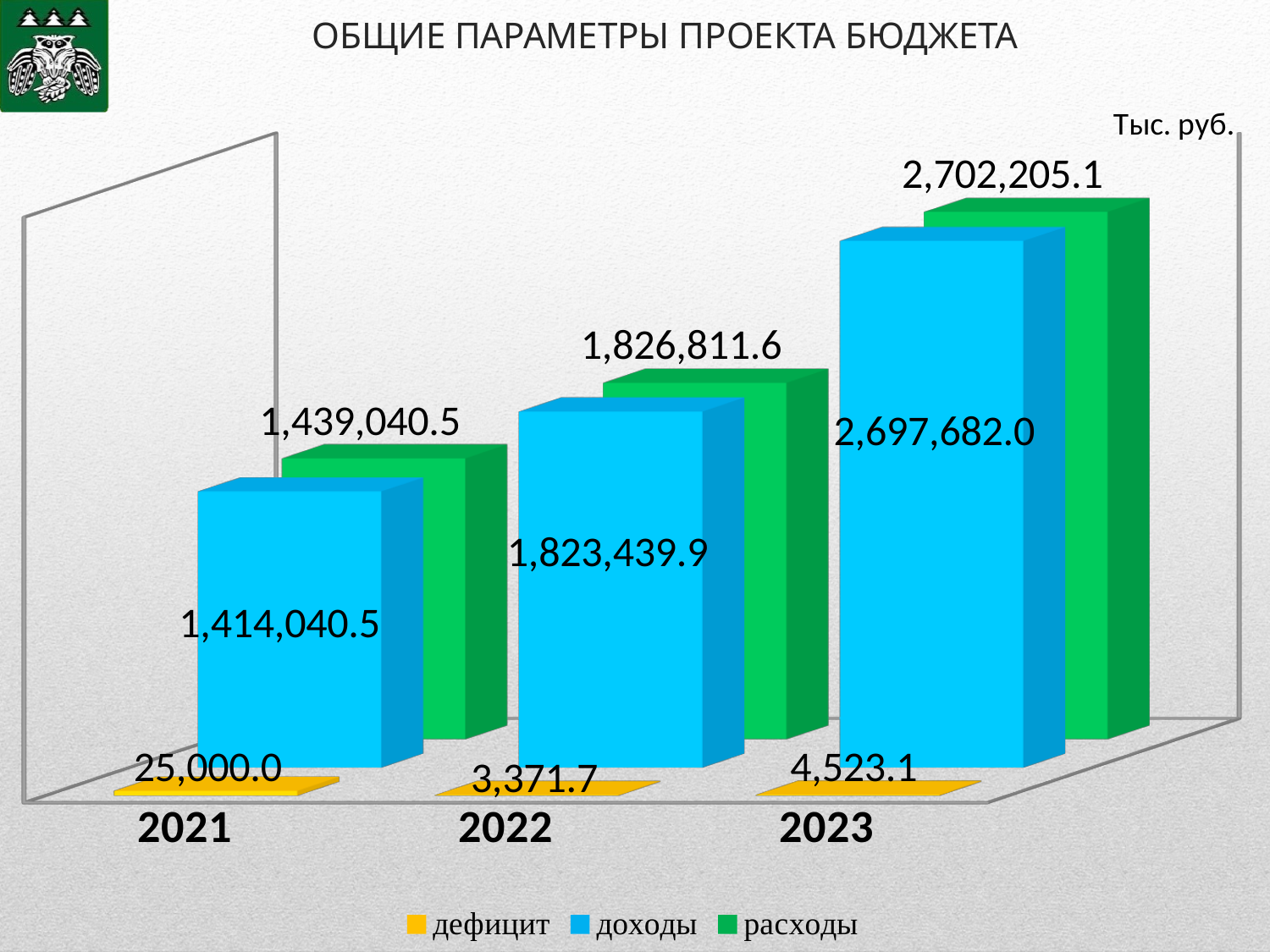
What is the value of дефицит for 2021? 25,000.0 In which year is расходы the highest? 2023 What is the value of расходы for 2023? 2,702,205.1 What is the difference between расходы and доходы in 2023? 4,523.1 In which year is дефицит the lowest? 2022 What kind of chart is shown on the slide? bar chart What is the value of доходы for 2022? 1,823,439.9 How many years are shown on the x axis? 3 What is the difference between расходы and доходы in 2021? 25,000.0 What is the value of доходы for 2021? 1,414,040.5 Which is larger: доходы in 2022 or доходы in 2021? доходы in 2022 How many series does the legend list? 3